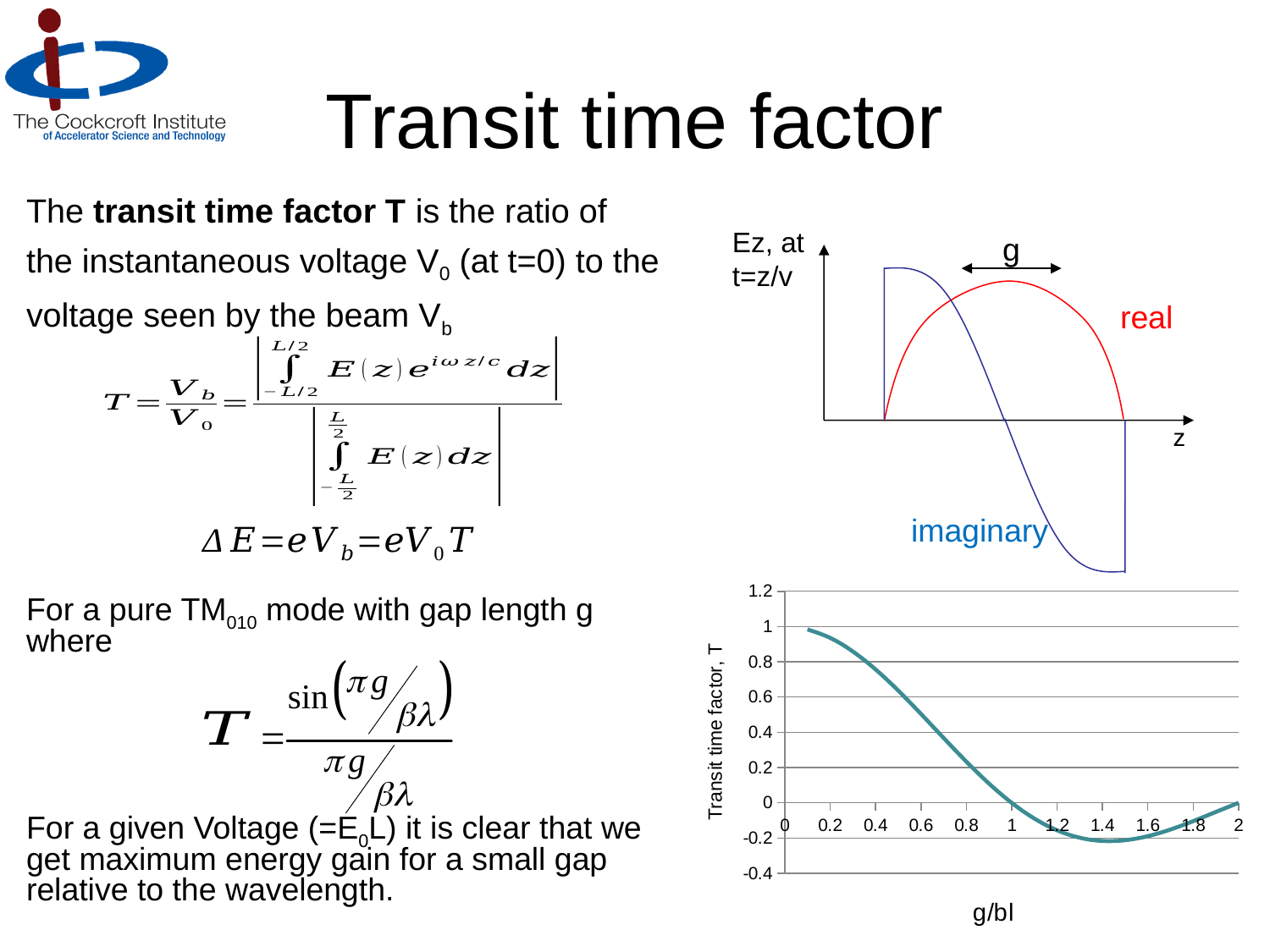
In the top-right chart of Ez versus z, how many curves are plotted? 2 In the bottom-right chart, does the transit time factor T rise or fall as g/bl increases from 0 to 1? fall In the top-right chart of Ez versus z, which curve is drawn in red? real In the bottom-right chart, is the value of T at g/bl = 0.2 greater or less than 0.8? greater In the bottom-right chart, is the value of T at g/bl = 0.8 greater or less than 0.4? less In the bottom-right chart, what is the value of T at g/bl = 1? 0 In the bottom-right chart, is the value of T at g/bl = 0.4 greater or less than 0.6? greater In the bottom-right chart, which has the larger value of T: g/bl = 0.4 or g/bl = 1.2? g/bl = 0.4 What kind of chart is the bottom-right chart with the x axis labelled g/bl? line chart In the bottom-right chart, what is the label of the y axis? Transit time factor, T